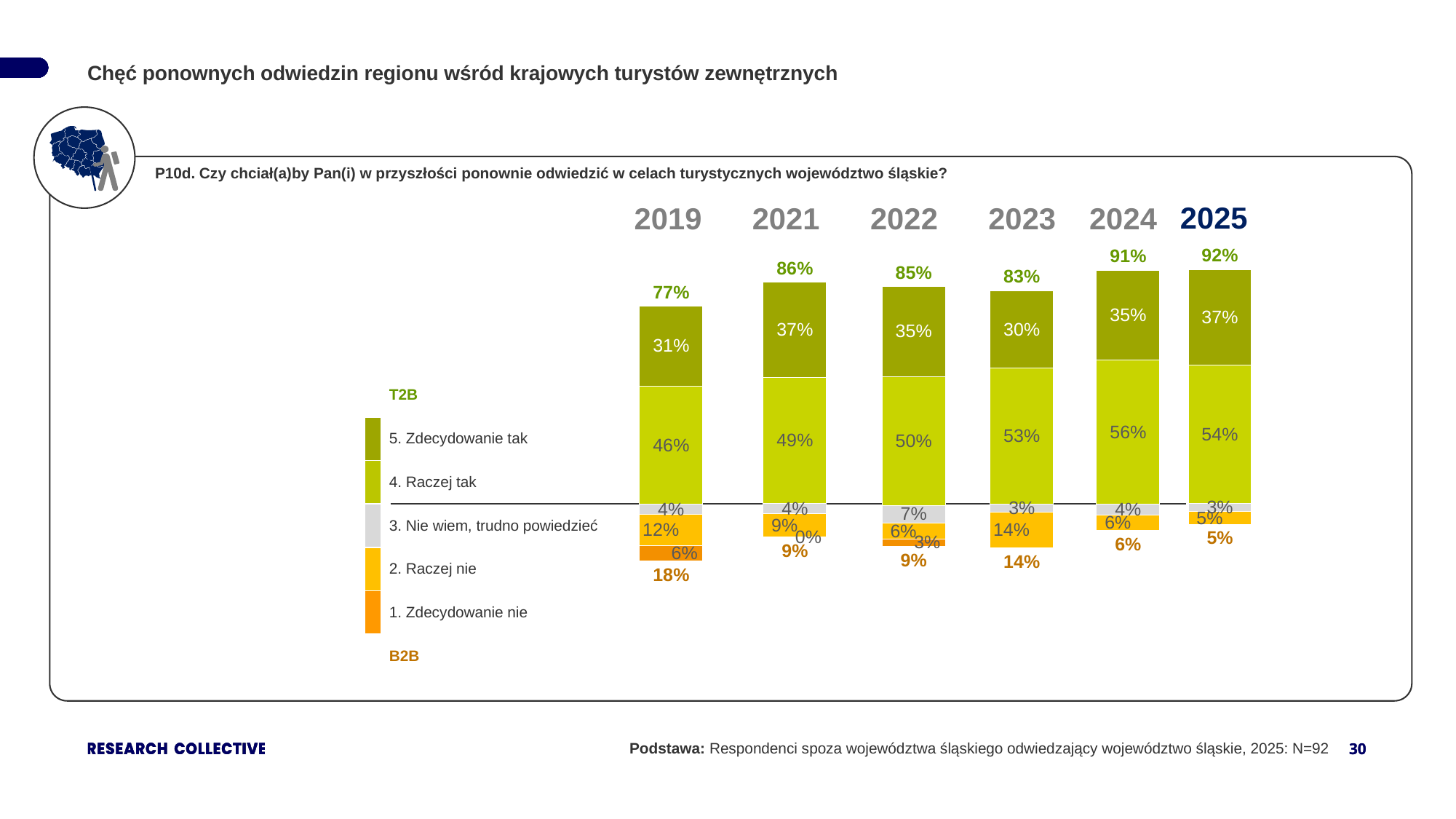
What is the value for "3. Nie wiem, trudno powiedzieć" in 2022? 7% What is the B2B value for 2023? 14% What is the value for "5. Zdecydowanie tak" in 2019? 31% Which year has the lowest T2B value? 2019 What is the difference between the T2B values for 2025 and 2019? 15 percentage points How many response categories does the legend list? 5 Which year has the highest T2B value? 2025 How many years are shown on the chart? 6 What kind of chart is shown on the slide? Stacked bar chart What is the value for "4. Raczej tak" in 2024? 56% Which is larger: the "2. Raczej nie" value in 2023 or in 2024? 2023 What is the T2B value for 2025? 92%